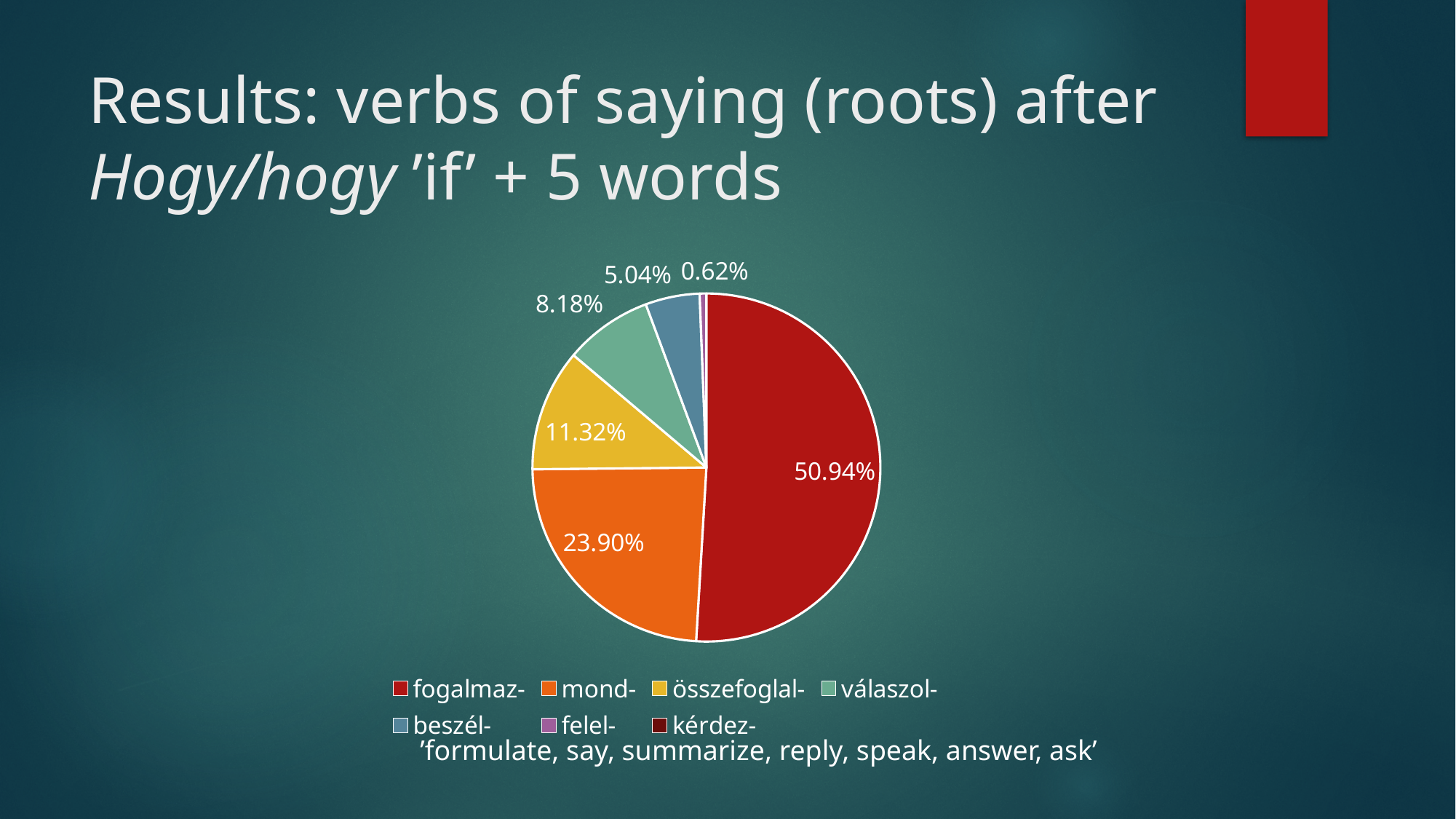
Which has the larger share, összefoglal- or válaszol-? összefoglal- What is the difference between the mond- and összefoglal- shares? 12.58% What is the value shown for mond-? 23.90% What percentage is shown for válaszol-? 8.18% What share is labelled for összefoglal-? 11.32% What percentage is labelled for felel-? 0.62% What is the difference in percentage points between fogalmaz- and mond-? 27.04% What percentage of the pie does fogalmaz- account for? 50.94% Which verb root has the largest slice of the pie? fogalmaz- What kind of chart is shown on the slide? pie chart What is the value for beszél-? 5.04% How many verb roots does the legend list? 7